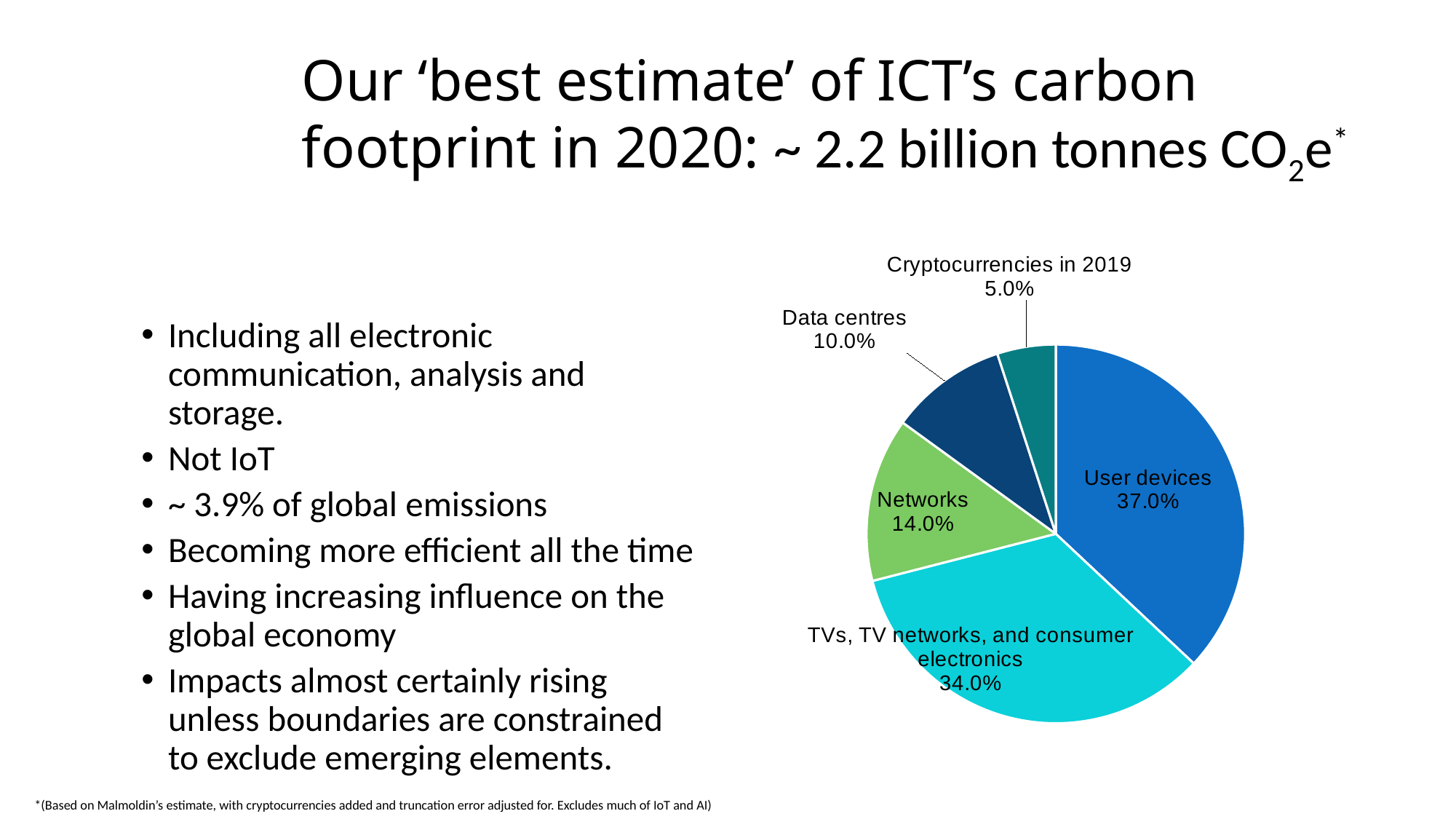
What is the difference in percentage points between User devices and TVs, TV networks, and consumer electronics? 3.0% Which is larger, Networks or Data centres? Networks How many slices does the pie chart have? 5 What share of the pie is User devices? 37.0% Which slice of the pie is the largest? User devices What is the combined share of Data centres and Cryptocurrencies in 2019? 15.0% What kind of chart is shown on the slide? pie chart What share of the pie is Networks? 14.0% What share of the pie is Data centres? 10.0% What share of the pie is Cryptocurrencies in 2019? 5.0% What share of the pie is TVs, TV networks, and consumer electronics? 34.0% Which slice of the pie is the smallest? Cryptocurrencies in 2019